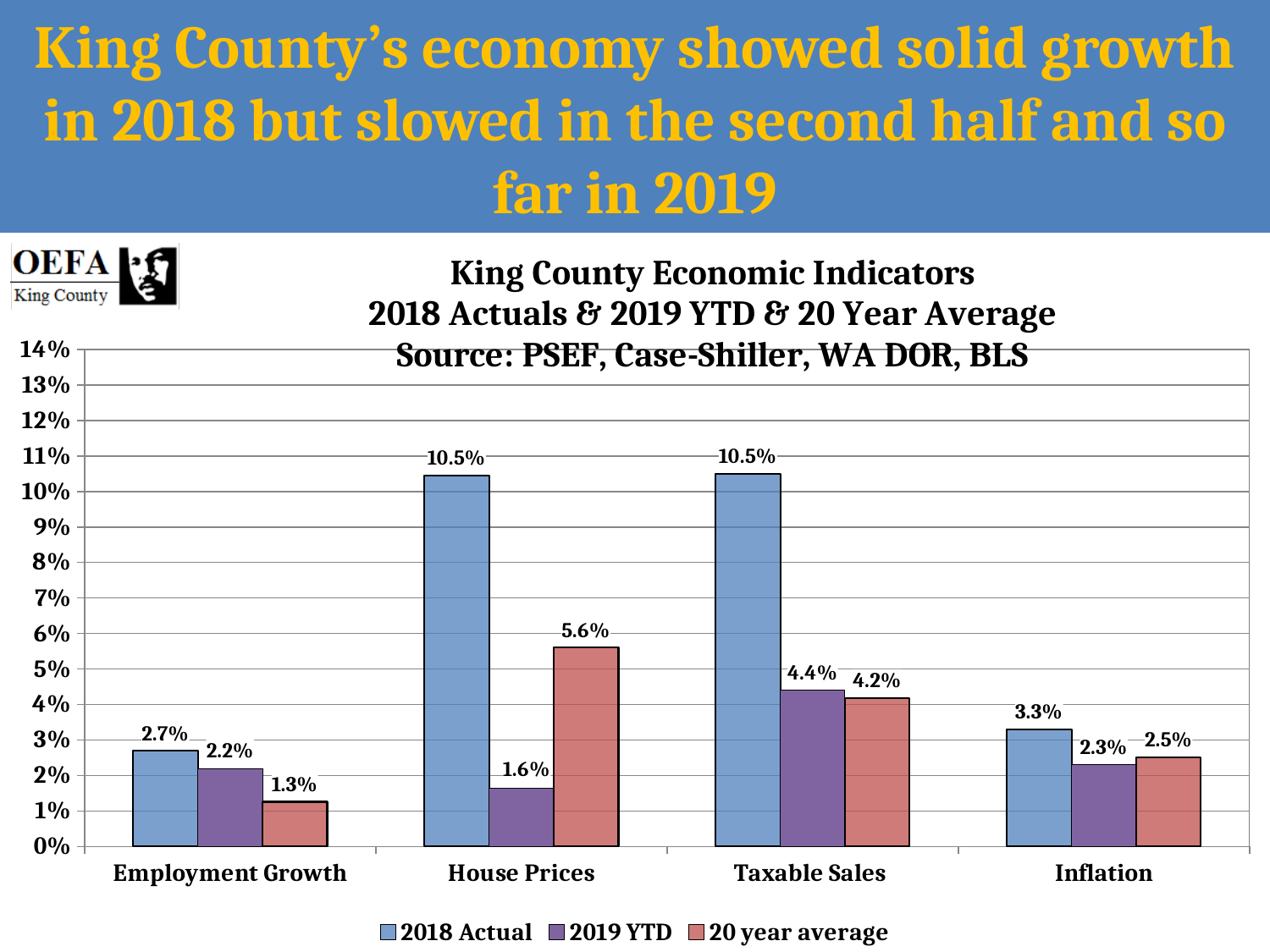
What is the 2018 Actual value for House Prices? 10.5% Which is larger for Inflation: the 2019 YTD value or the 20 year average value? 20 year average What is the 20 year average value for Taxable Sales? 4.2% What is the difference between the 2018 Actual and 2019 YTD values for House Prices? 8.9% What kind of chart is shown on the slide? Bar chart How many series does the legend list? 3 Which category has the highest 2019 YTD value? Taxable Sales What is the 2019 YTD value for Inflation? 2.3% Which category has the lowest 20 year average value? Employment Growth What is the 2019 YTD value for Employment Growth? 2.2% How many categories are shown on the x axis? 4 What is the difference between the 2018 Actual and 20 year average values for Inflation? 0.8%